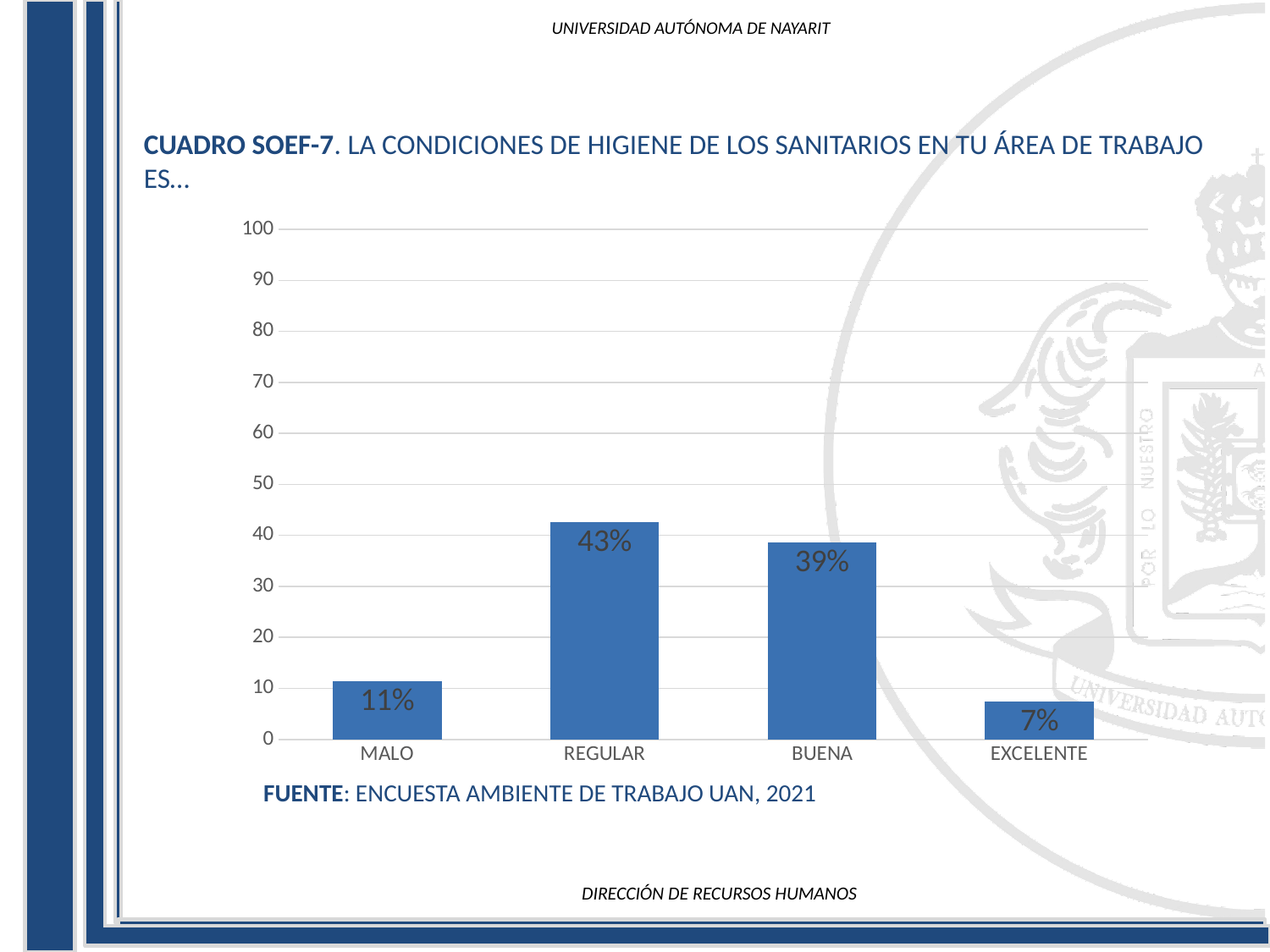
Which category has the lowest value? EXCELENTE What is the difference between the values for MALO and EXCELENTE? 4% What is the value for MALO? 11% What source is cited below the chart? ENCUESTA AMBIENTE DE TRABAJO UAN, 2021 How many categories are shown on the x axis? 4 What is the value for REGULAR? 43% What kind of chart is shown on the slide? Bar chart Which is larger, the value for MALO or the value for BUENA? BUENA What is the difference between the values for REGULAR and BUENA? 4% Which category has the highest value? REGULAR What is the value for EXCELENTE? 7% What is the value for BUENA? 39%